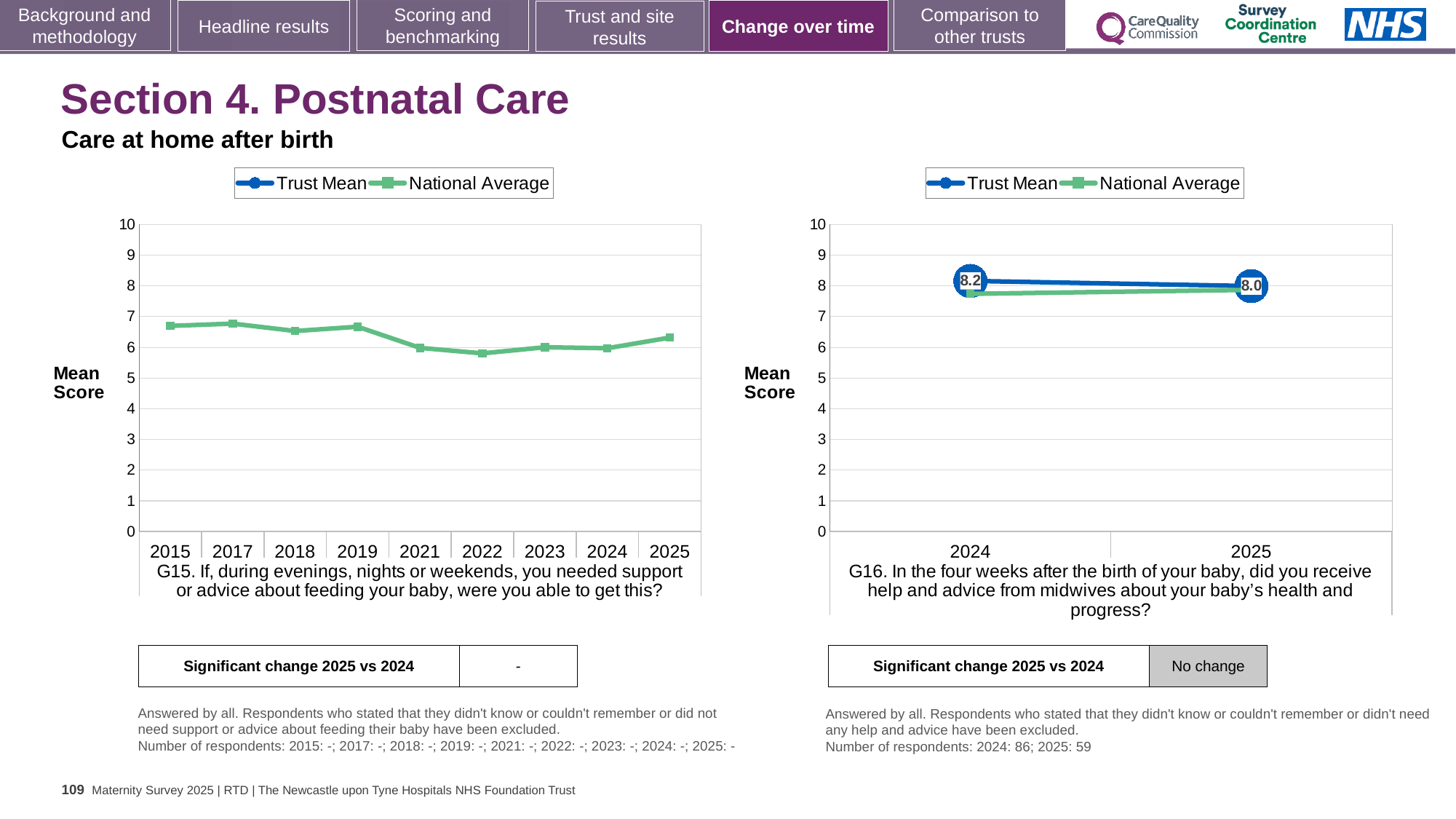
On the left chart (G15), is the National Average for 2015 greater or less than 6? greater On the left chart (G15), how many series does the legend list? 2 On the right chart (G16), does the Trust Mean rise or fall from 2024 to 2025? fall On the right chart (G16), what is the Trust Mean for 2025? 8.0 On the right chart (G16), what is the difference between the Trust Mean in 2024 and in 2025? 0.2 What kind of chart is the left chart (G15)? line chart On the right chart (G16), how many years are shown on the x axis? 2 On the left chart (G15), how many years are shown on the x axis? 9 On the right chart (G16), which year has the higher Trust Mean, 2024 or 2025? 2024 On the left chart (G15), does the National Average rise or fall from 2019 to 2022? fall On the right chart (G16), what is the Trust Mean for 2024? 8.2 On the right chart (G16), is the National Average for 2024 greater or less than 7? greater